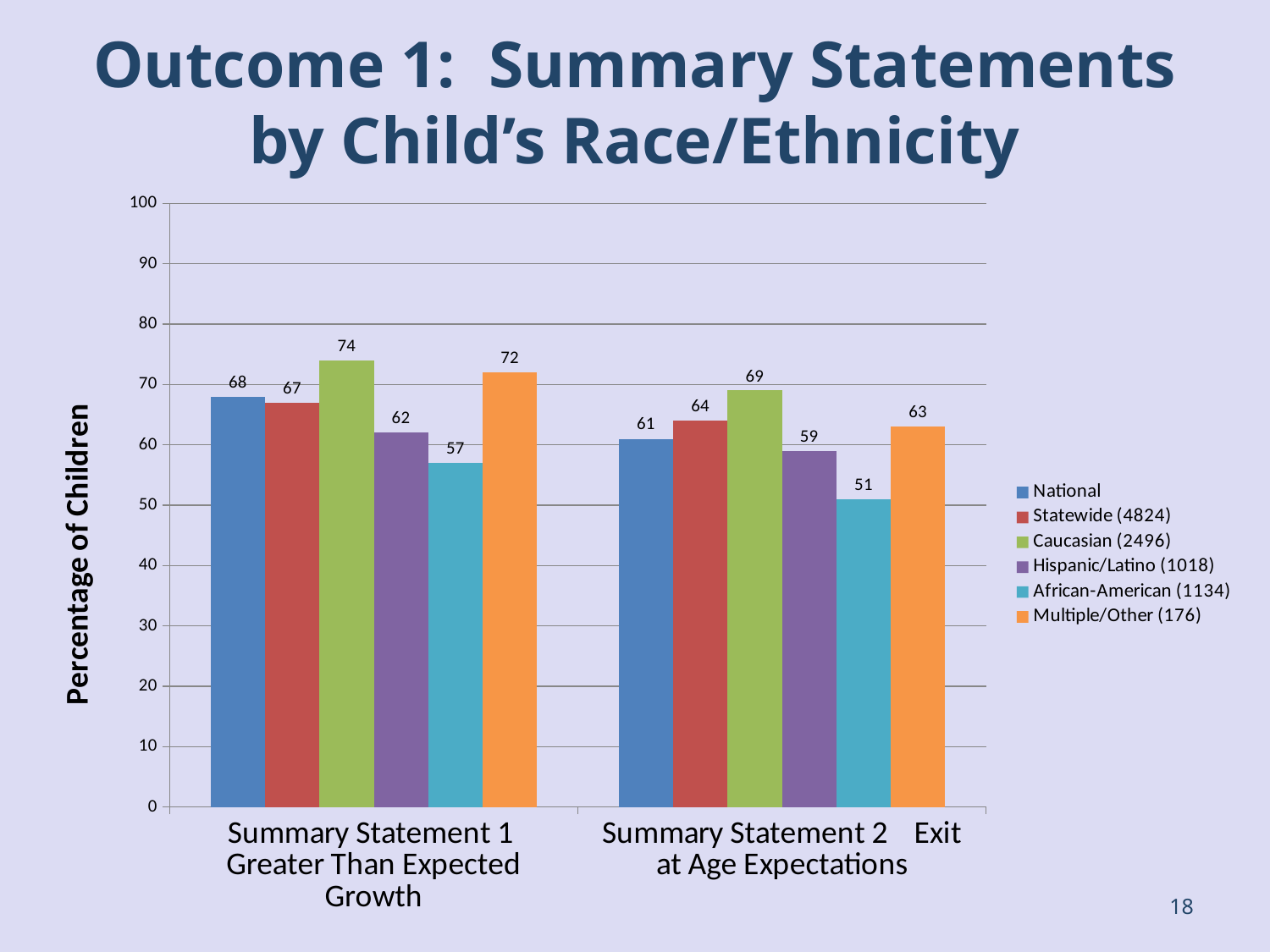
How many categories are shown on the x axis? 2 Is the Multiple/Other (176) value for Summary Statement 1 Greater Than Expected Growth greater or less than 70? greater Which series has the highest value in Summary Statement 1 Greater Than Expected Growth? Caucasian (2496) Which series has the lowest value in Summary Statement 2 Exit at Age Expectations? African-American (1134) What is the National value for Summary Statement 2 Exit at Age Expectations? 61 What is the value for Caucasian (2496) in Summary Statement 1 Greater Than Expected Growth? 74 What is the label of the vertical axis? Percentage of Children What is the difference between the Caucasian (2496) and African-American (1134) values in Summary Statement 1 Greater Than Expected Growth? 17 What kind of chart is shown on the slide? Bar chart How many series does the legend list? 6 Which is larger for Summary Statement 2 Exit at Age Expectations: Statewide (4824) or Hispanic/Latino (1018)? Statewide (4824) What is the value for African-American (1134) in Summary Statement 2 Exit at Age Expectations? 51